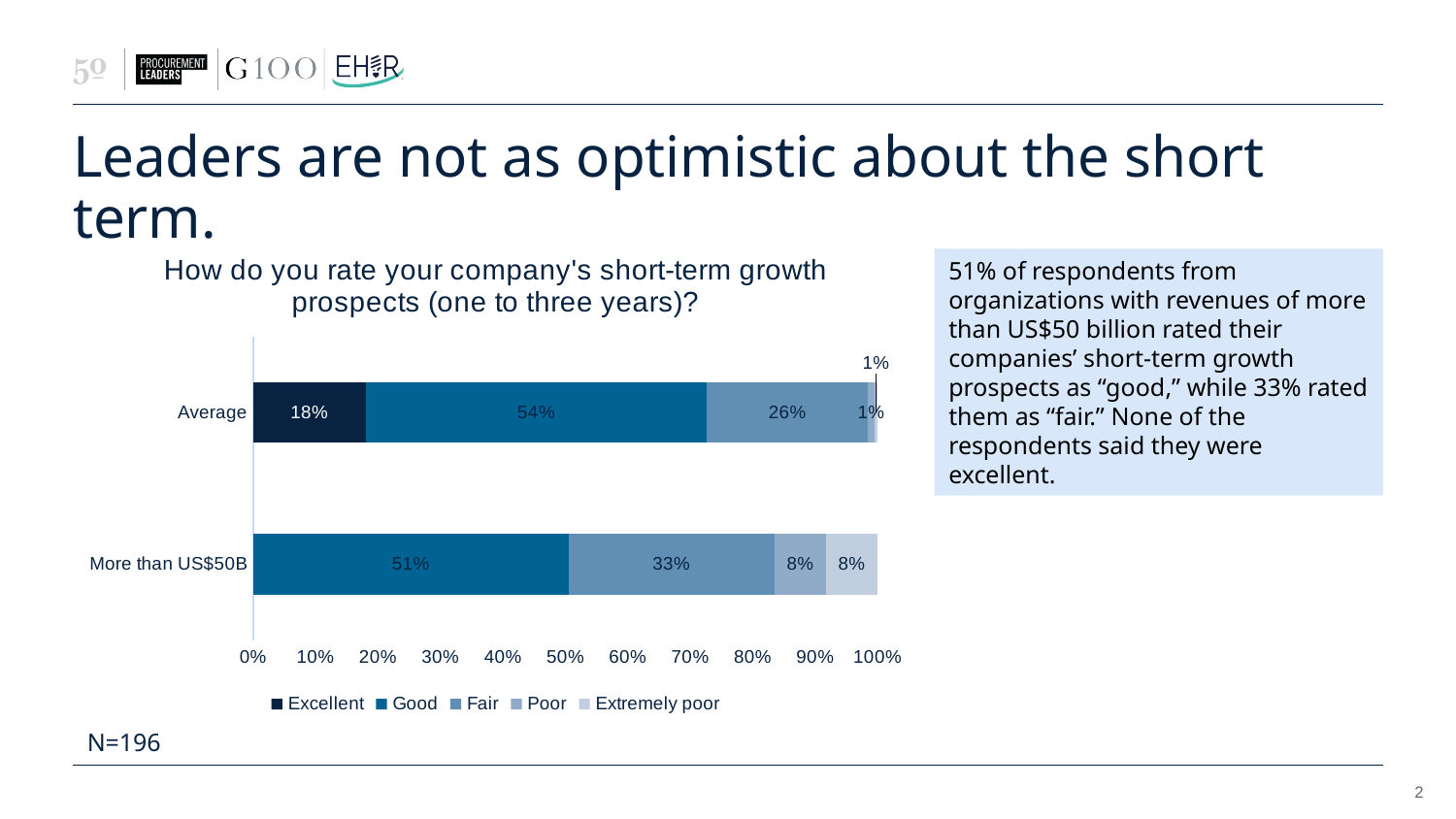
What kind of chart is shown on the slide? Stacked bar chart How many series does the legend list? 5 How many categories are plotted on the chart? 2 What is the value for Excellent in the Average category? 18% What is the value for Fair in the More than US$50B category? 33% Which is larger: the Fair value for Average or the Fair value for More than US$50B? More than US$50B What is the value for Good in the Average category? 54% What is the sample size (N) stated on the slide? N=196 What is the value for Poor in the More than US$50B category? 8% What is the difference between the Good values for Average and More than US$50B? 3% Which rating has the highest value in the More than US$50B category? Good What is the chart's title? How do you rate your company's short-term growth prospects (one to three years)?